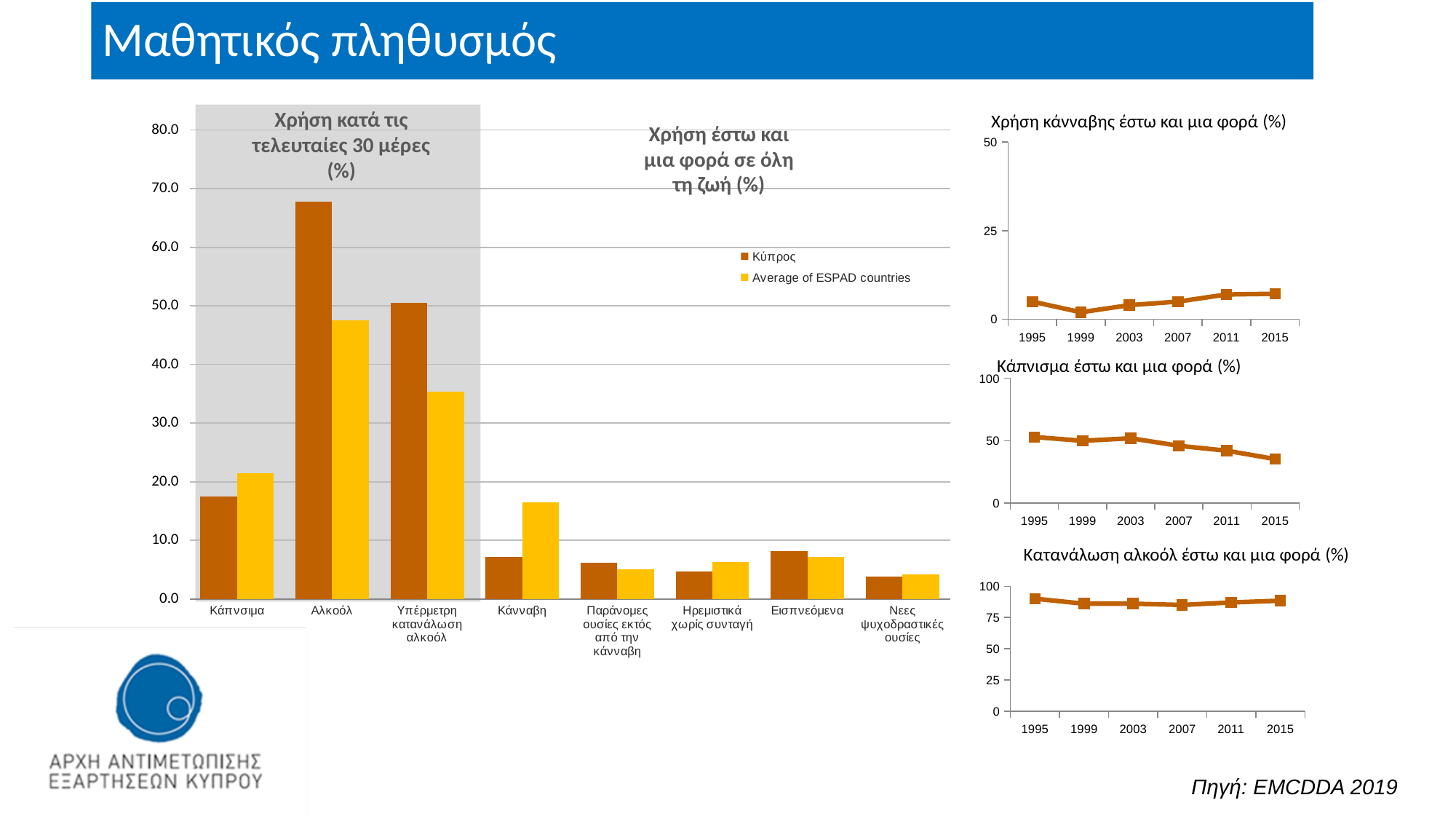
How many series does the legend of the large bar chart on the left list? 2 How many categories are shown on the x axis of the large bar chart on the left? 8 In the large bar chart on the left, for Κάπνισμα, which is larger: Κύπρος or Average of ESPAD countries? Average of ESPAD countries In the chart titled 'Κάπνισμα έστω και μια φορά (%)', do the values rise or fall from 1995 to 2015? fall In the chart titled 'Κατανάλωση αλκοόλ έστω και μια φορά (%)', is the value for 2015 greater or less than 75? greater In the large bar chart on the left, is the Average of ESPAD countries value for Κάνναβη greater or less than 10? greater In the large bar chart on the left, which category has the highest value for Κύπρος? Αλκοόλ In the chart titled 'Χρήση κάνναβης έστω και μια φορά (%)', which year has the lowest value? 1999 What kind of chart is the large chart on the left of the slide? bar chart In the large bar chart on the left, is the Average of ESPAD countries value for Αλκοόλ greater or less than 50? less In the large bar chart on the left, for Κάνναβη, which is larger: Κύπρος or Average of ESPAD countries? Average of ESPAD countries